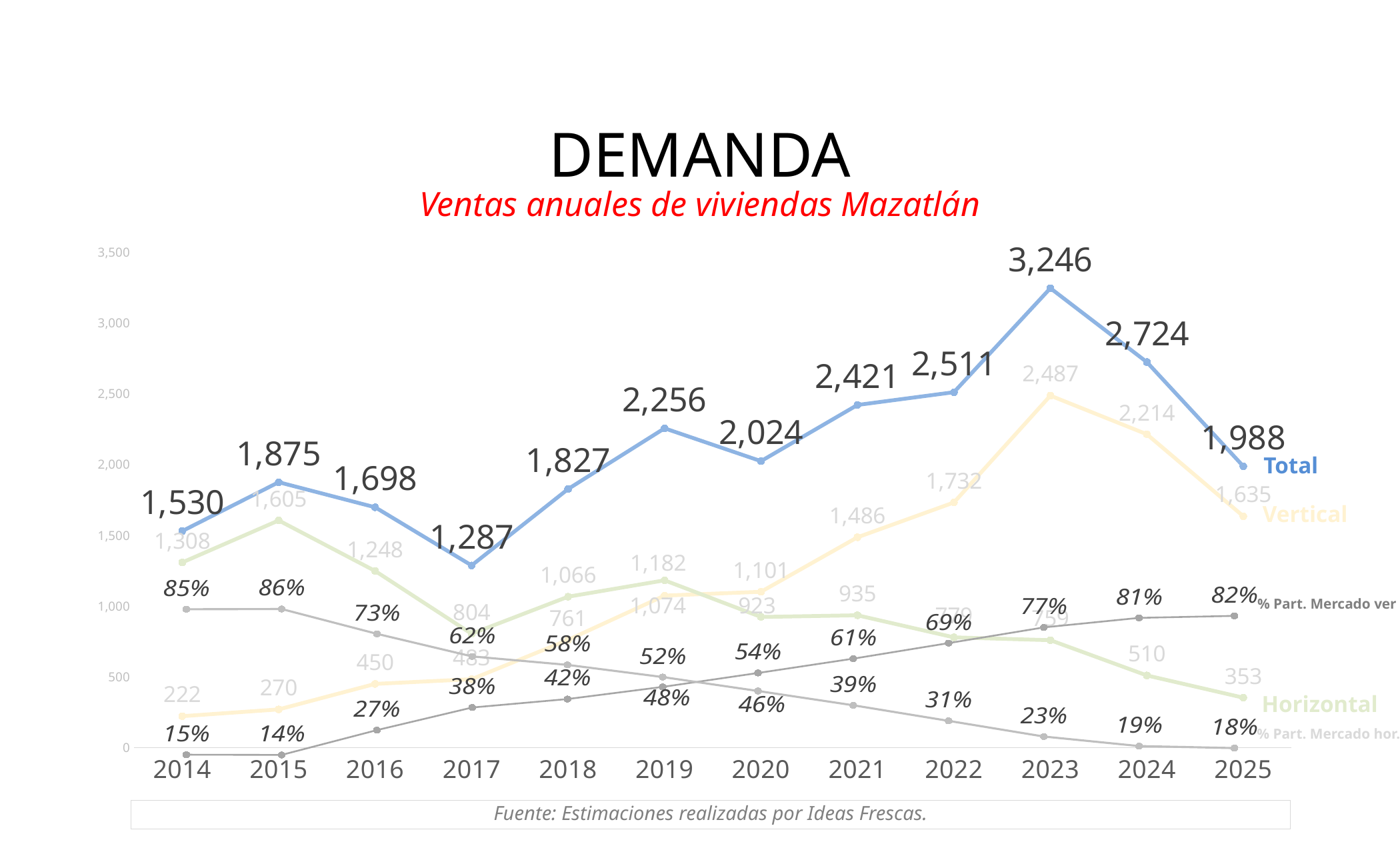
What is the Horizontal value for 2015? 1,605 In 2025, which is larger, the Vertical value or the Horizontal value? Vertical What is the Total value for 2014? 1,530 Does the Horizontal series rise or fall from 2019 to 2025? Fall What is the red subtitle of the chart? Ventas anuales de viviendas Mazatlán What is the difference between the Total values for 2023 and 2024? 522 What is the Total value for 2023? 3,246 What is the Vertical value for 2023? 2,487 What kind of chart is shown on the slide? Line chart In which year is the Total series highest? 2023 How many years are shown on the x axis? 12 In which year is the Total series lowest? 2017